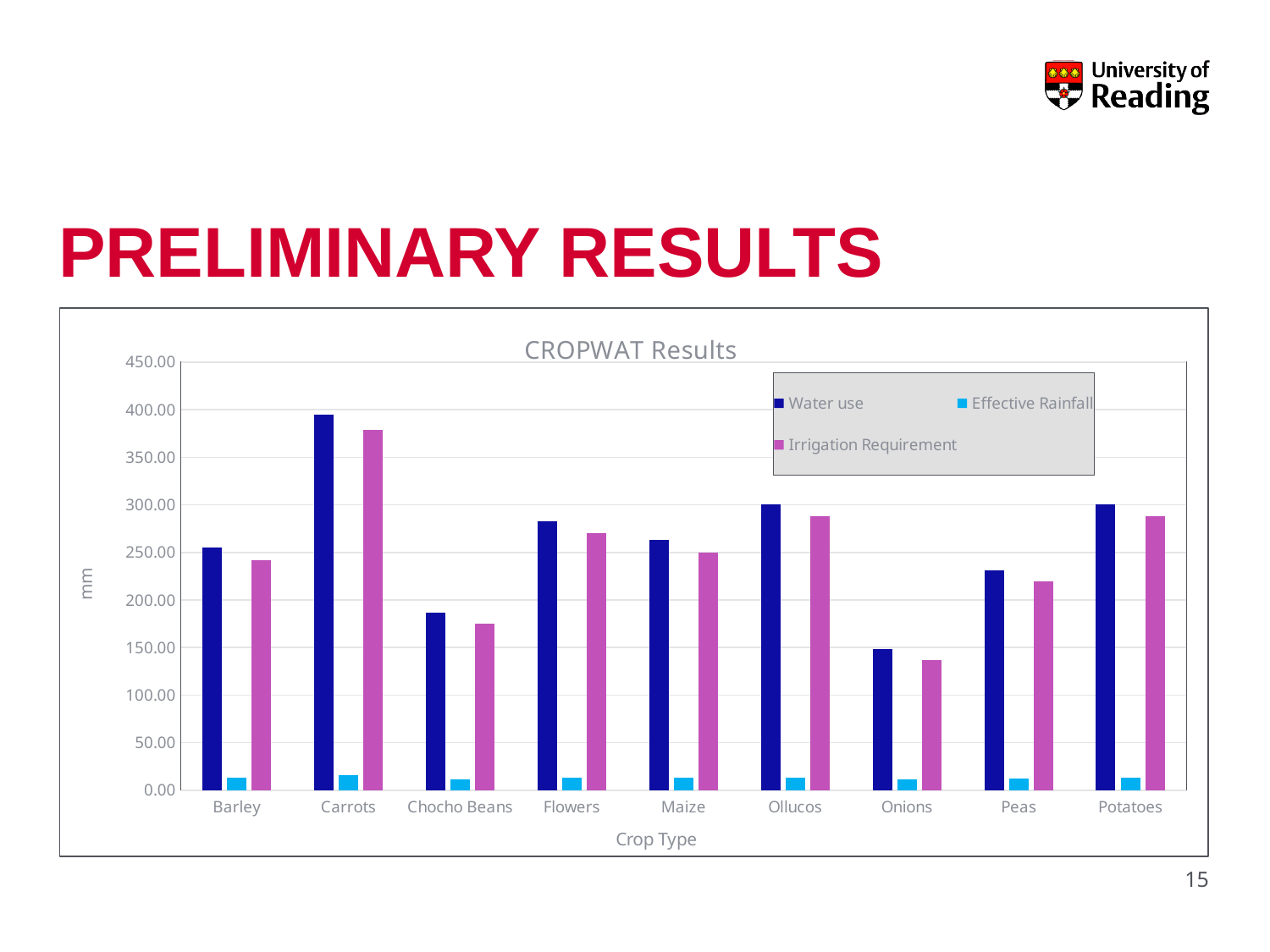
Is the Water use value for Chocho Beans greater or less than 200? less Is the Water use value for Carrots greater or less than 350? greater Which crop type has the highest Water use? Carrots How many crop types are shown on the x axis? 9 Is the Irrigation Requirement value for Onions greater or less than 150? less What type of chart is shown on the slide? bar chart What is the title of the chart? CROPWAT Results How many series does the legend list? 3 Which crop type has the lowest Irrigation Requirement? Onions Which has the larger Water use, Flowers or Maize? Flowers Which crop type has the lowest Water use? Onions Which has the larger Irrigation Requirement, Barley or Peas? Barley